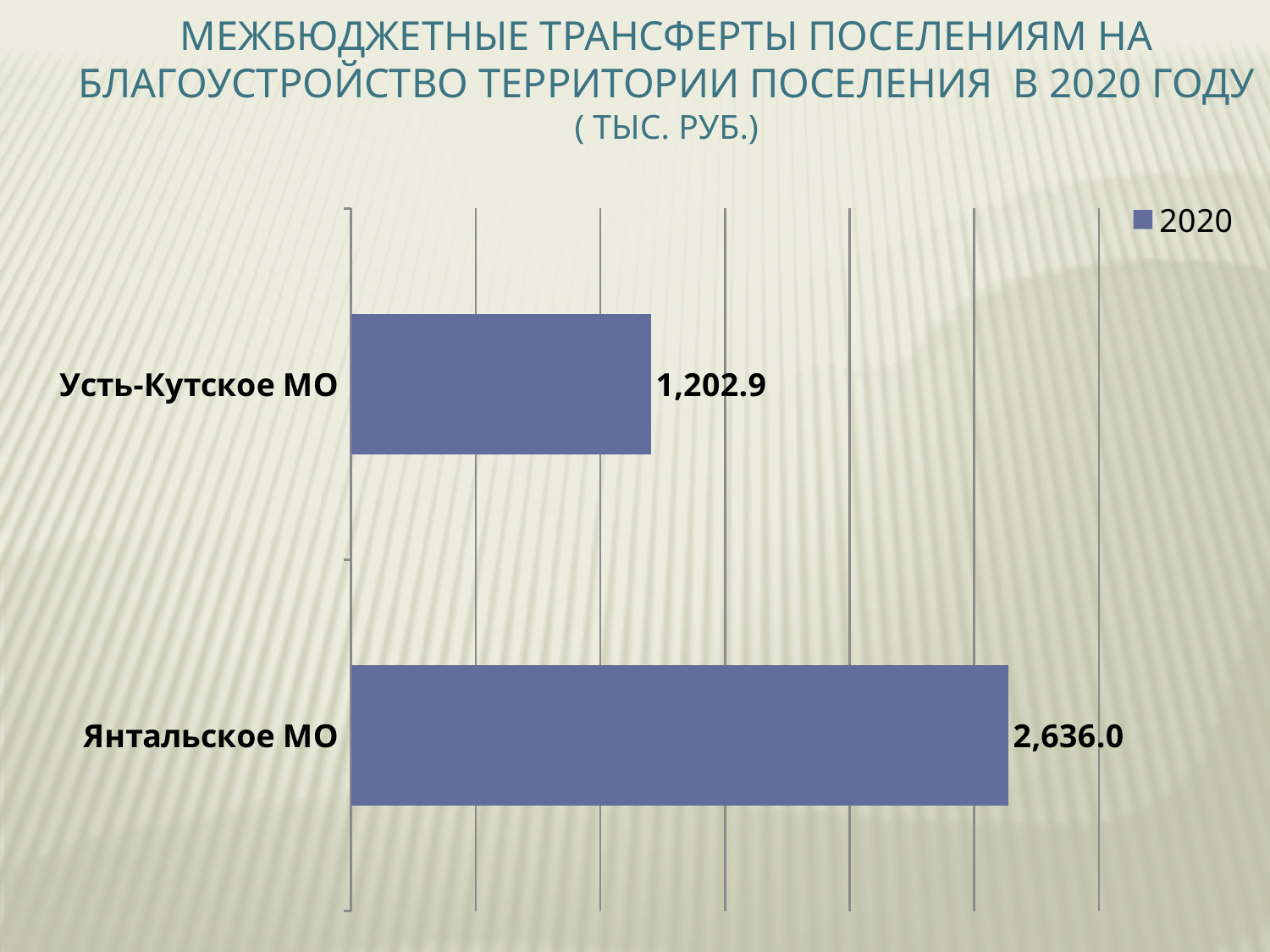
Which is larger, the value for Усть-Кутское МО or the value for Янтальское МО? Янтальское МО Which category has the highest value? Янтальское МО What is the value for Усть-Кутское МО? 1,202.9 How many categories are shown in the chart? 2 What is the difference between the values for Янтальское МО and Усть-Кутское МО? 1,433.1 What unit is given in the chart title? тыс. руб. What is the value for Янтальское МО? 2,636.0 Which category has the lowest value? Усть-Кутское МО What series name is shown in the legend? 2020 How many series does the legend list? 1 What kind of chart is shown on the slide? Bar chart